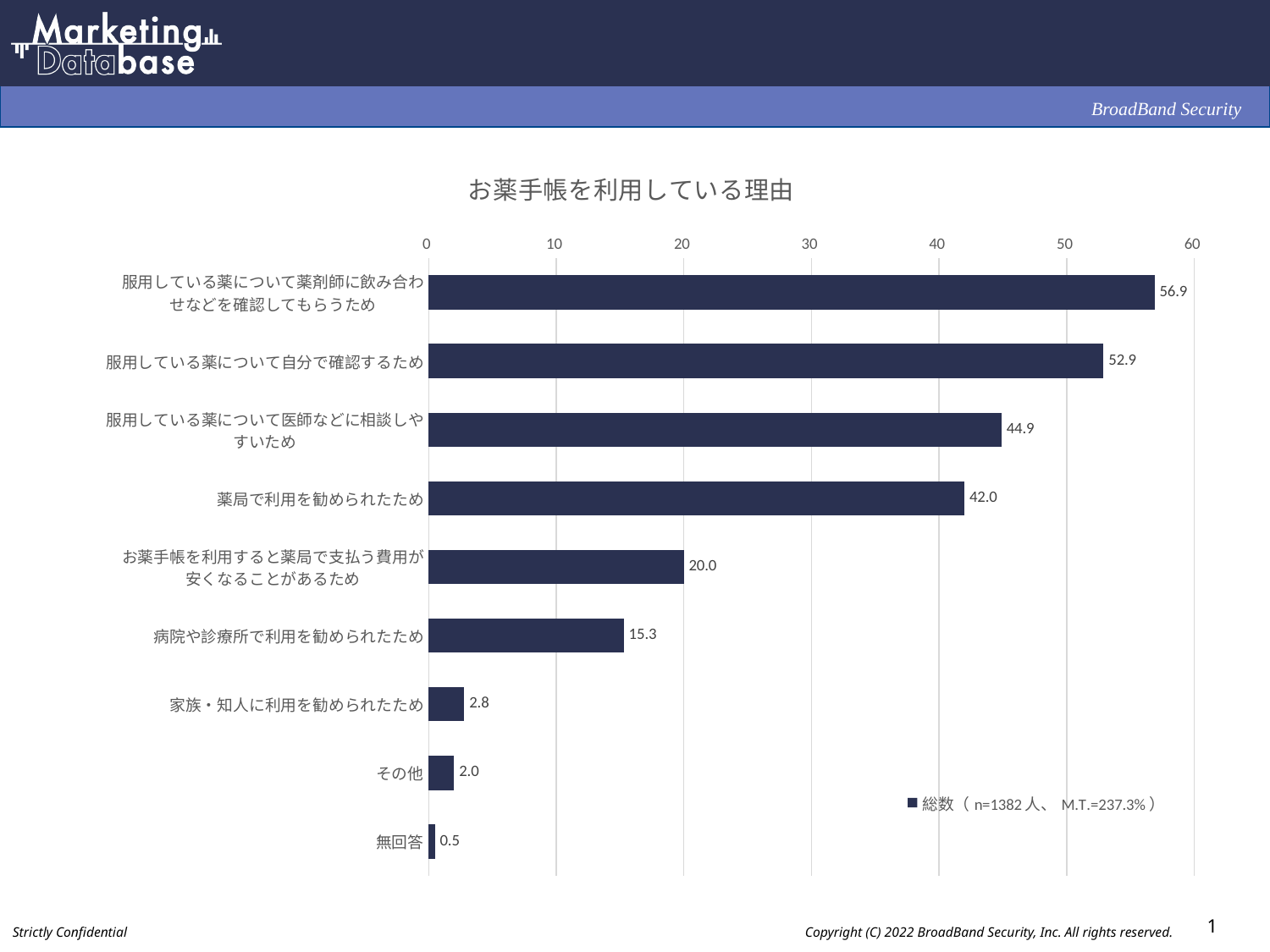
Which category has the highest value? 服用している薬について薬剤師に飲み合わせなどを確認してもらうため What kind of chart is shown on the slide? bar chart How many categories are shown in the chart? 9 How many series does the legend list? 1 What is the value for 薬局で利用を勧められたため? 42.0 Is the value for お薬手帳を利用すると薬局で支払う費用が安くなることがあるため greater or less than 30? less What is the value for 病院や診療所で利用を勧められたため? 15.3 What is the value for 服用している薬について自分で確認するため? 52.9 Which category has the lowest value? 無回答 Which is larger, the value for 家族・知人に利用を勧められたため or the value for その他? 家族・知人に利用を勧められたため What is the title of the chart? お薬手帳を利用している理由 What is the difference between the values for 服用している薬について医師などに相談しやすいため and 薬局で利用を勧められたため? 2.9